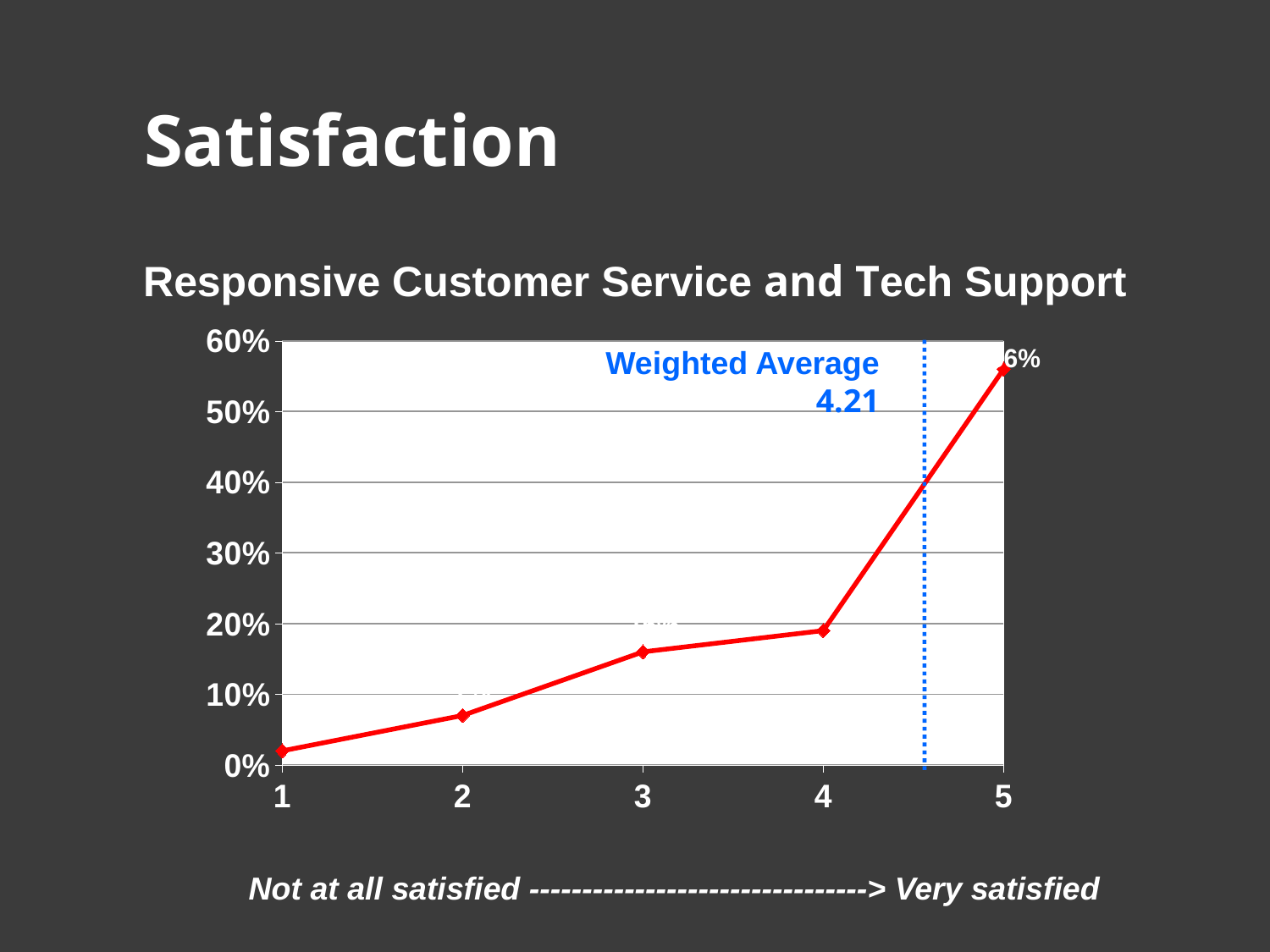
Which rating on the x axis has the highest percentage? 5 Which has the larger value, rating 5 or rating 4? 5 Is the value for rating 2 greater or less than 10%? less What weighted average is printed on the chart? 4.21 What is the title of the chart? Responsive Customer Service and Tech Support Is the value for rating 5 greater or less than 50%? greater Which rating on the x axis has the lowest percentage? 1 What kind of chart is shown on the slide? line chart Do the values rise or fall as the rating goes from 1 to 5? rise Is the value for rating 3 greater or less than 10%? greater How many data points are plotted on the line? 5